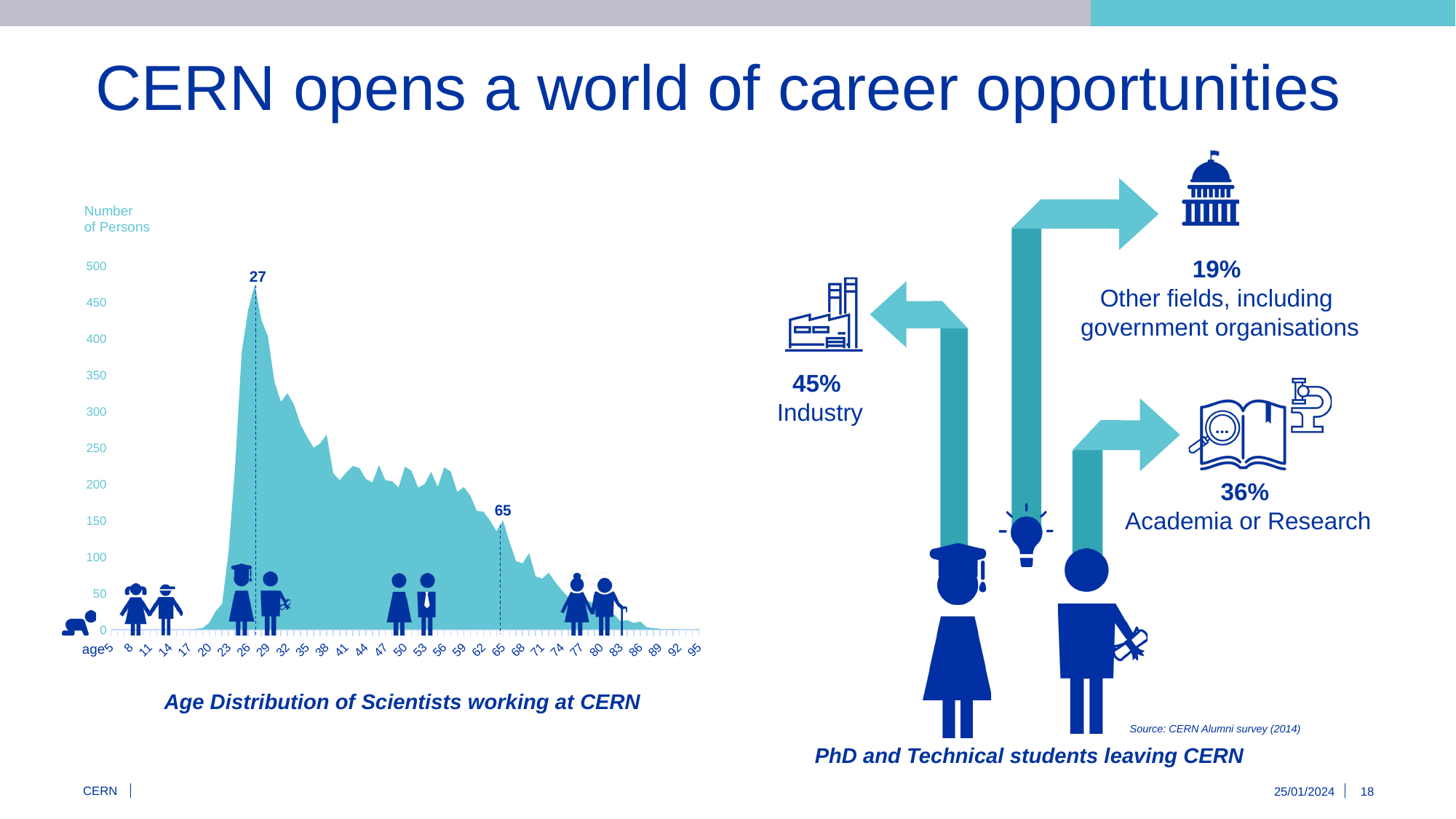
In the 'Age Distribution of Scientists working at CERN' chart, what is the label of the vertical axis? Number of Persons What kind of chart is the 'Age Distribution of Scientists working at CERN' chart? area chart In the 'Age Distribution of Scientists working at CERN' chart, which age has more persons, 27 or 65? 27 In the 'PhD and Technical students leaving CERN' diagram on the right, what is the difference between the Industry share and the Academia or Research share? 9% In the 'Age Distribution of Scientists working at CERN' chart, is the number of persons at age 80 greater or less than 100? less In the 'Age Distribution of Scientists working at CERN' chart, is the number of persons at age 20 greater or less than 50? less In the 'Age Distribution of Scientists working at CERN' chart, is the number of persons at age 65 greater or less than 200? less In the 'Age Distribution of Scientists working at CERN' chart, what is the highest value shown on the vertical axis? 500 In the 'PhD and Technical students leaving CERN' diagram on the right, what percentage go to Industry? 45% In the 'Age Distribution of Scientists working at CERN' chart, do the values rise or fall as age increases from 27 to 95? fall In the 'Age Distribution of Scientists working at CERN' chart, at which age does the number of persons peak? 27